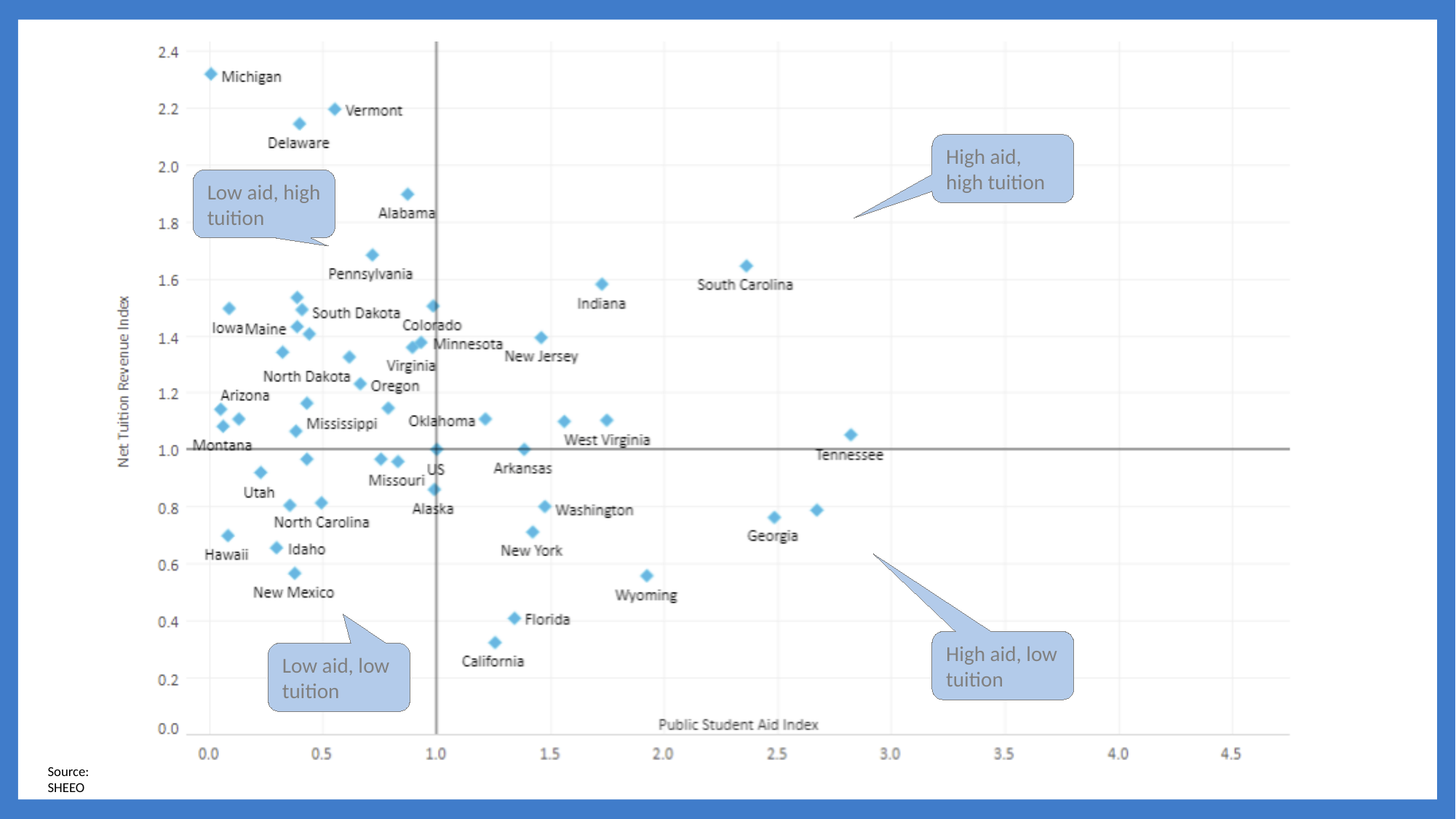
Is the Net Tuition Revenue Index for Michigan greater or less than 2.0? greater Is the Net Tuition Revenue Index for California greater or less than 0.5? less Is the Public Student Aid Index for Wyoming greater or less than 1.5? greater Which state has the highest Net Tuition Revenue Index? Michigan Which has the higher Net Tuition Revenue Index, Michigan or Vermont? Michigan What kind of chart is shown on the slide? Scatter plot Which has the higher Public Student Aid Index, South Carolina or Indiana? South Carolina What is the Net Tuition Revenue Index for the US point, where the two reference lines cross? 1.0 Which state has the lowest Net Tuition Revenue Index? California What is the label of the horizontal axis? Public Student Aid Index Which state has the highest Public Student Aid Index? Tennessee